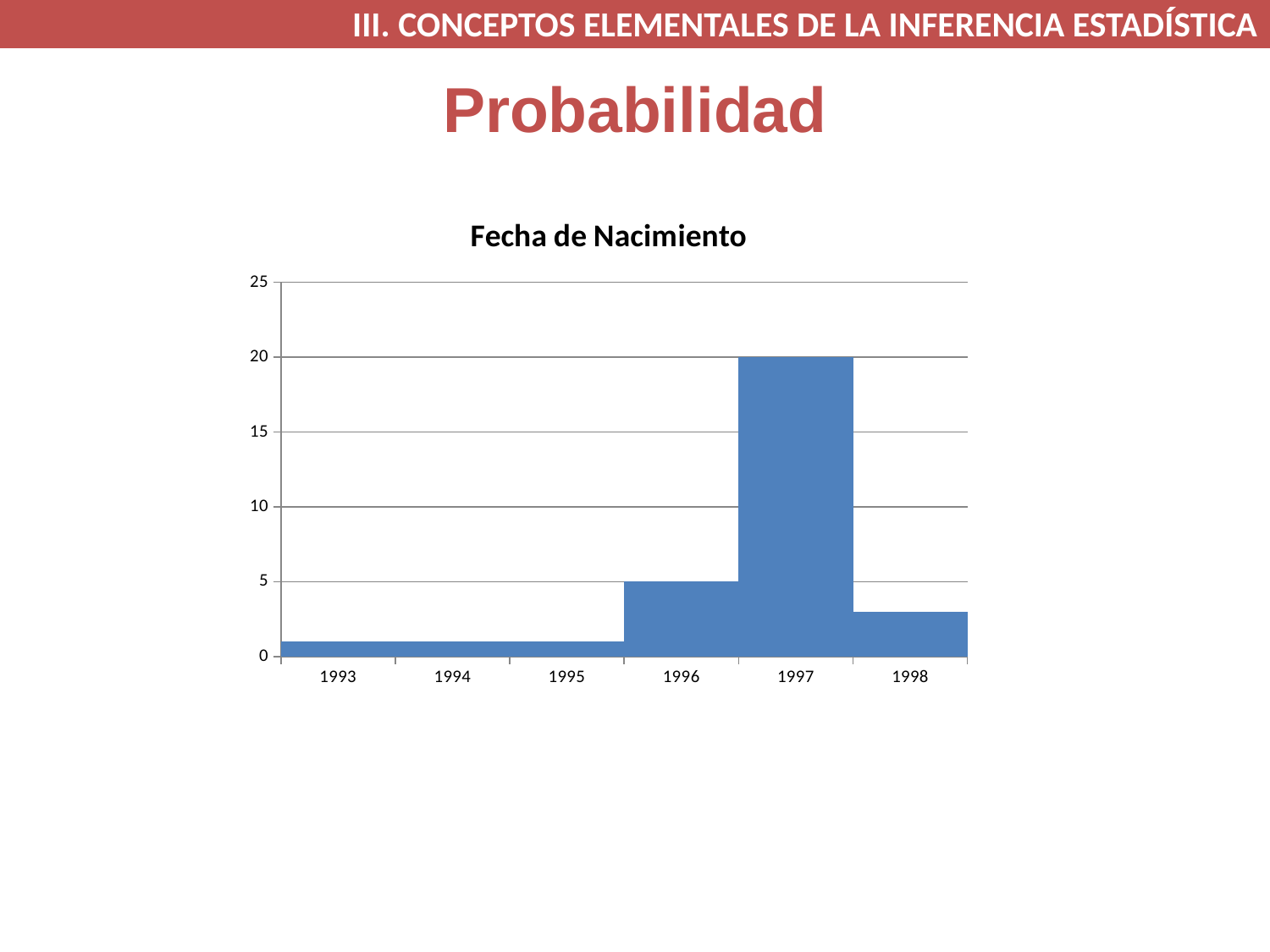
What is the title of the chart? Fecha de Nacimiento Is the value for 1993 greater or less than 5? less Is the value for 1998 greater or less than 5? less Which year has the highest value in the chart? 1997 Do the values rise or fall from 1995 to 1997? rise Which has the larger value, 1996 or 1998? 1996 What is the difference between the values for 1997 and 1996? 15 What kind of chart is shown on the slide? bar chart What is the value for 1996? 5 How many years are shown on the x axis of the chart? 6 What is the value for 1997? 20 Is the value for 1997 greater or less than 15? greater